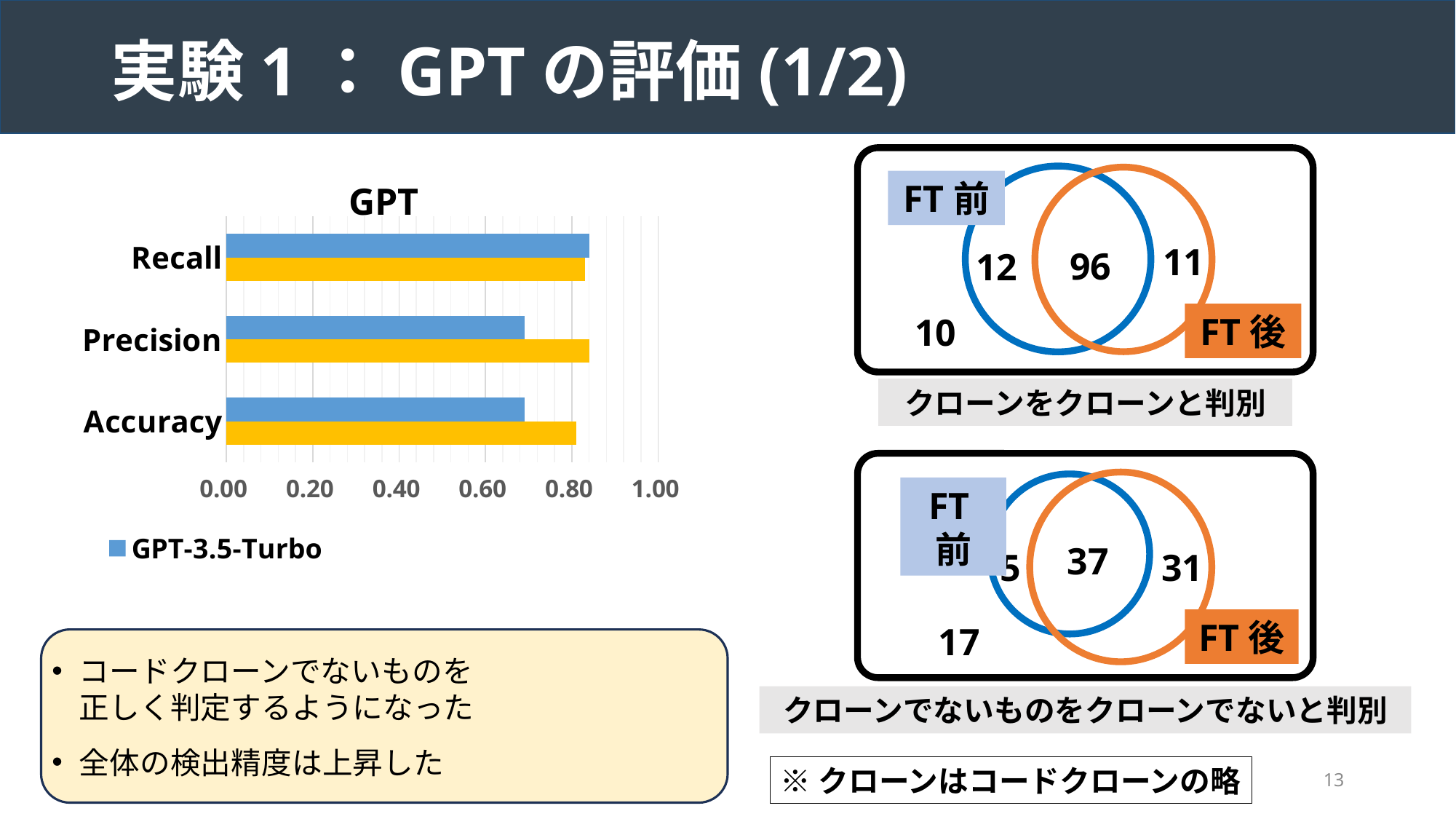
Is the GPT-3.5-Turbo value for Precision greater or less than 0.80? less For Accuracy, is the blue bar or the yellow bar longer? yellow Is the GPT-3.5-Turbo value for Accuracy greater or less than 0.60? greater Is the GPT-3.5-Turbo value for Recall greater or less than 0.80? greater Which series name appears in the legend of the bar chart? GPT-3.5-Turbo What kind of chart is shown on the left of the slide? bar chart What is the title of the bar chart? GPT For Precision, is the blue bar or the yellow bar longer? yellow How many categories are shown on the bar chart? 3 Which category has the highest value for GPT-3.5-Turbo in the bar chart? Recall How many series does the legend of the bar chart list? 1